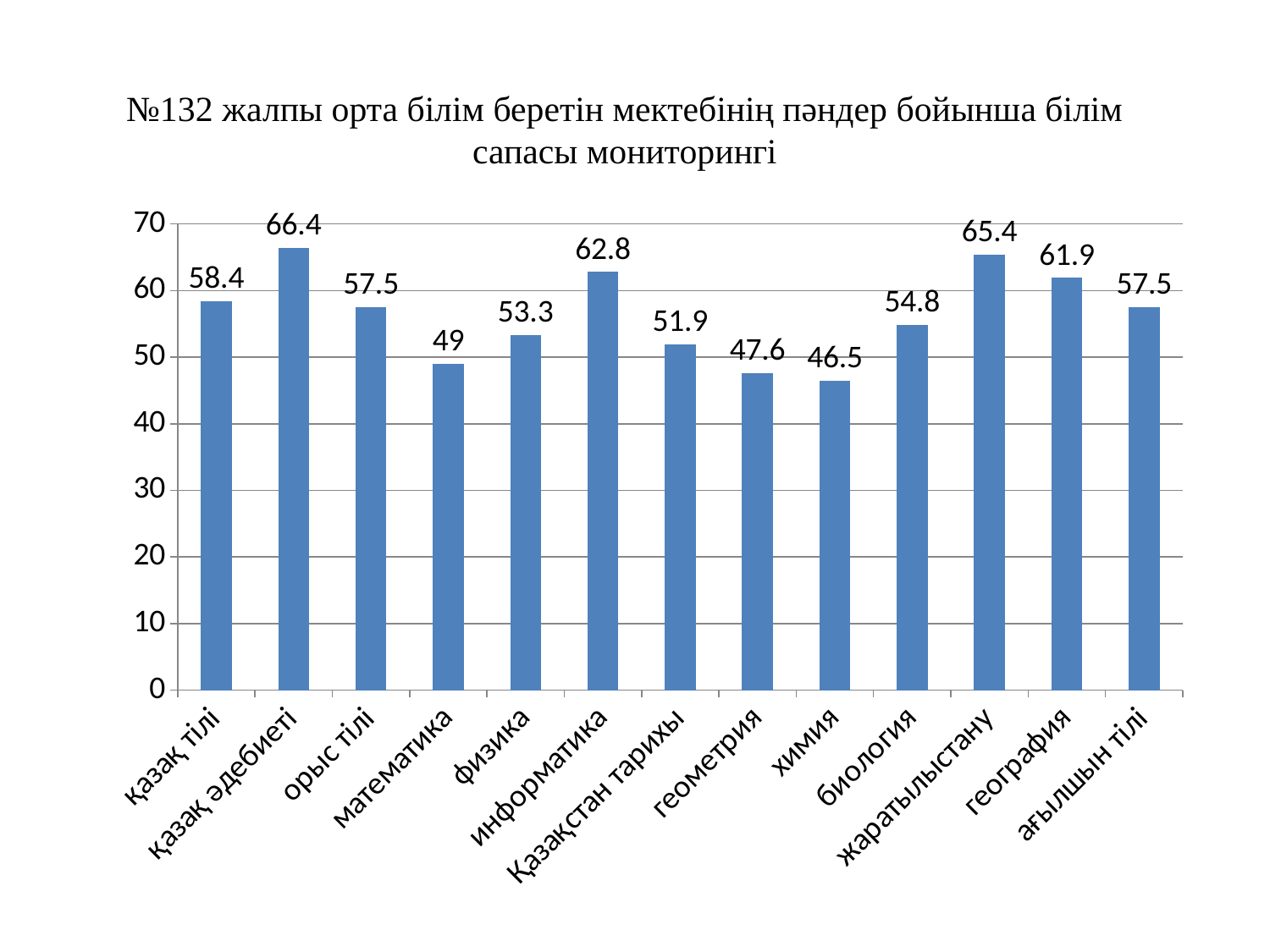
How many subjects are shown on the chart? 13 What kind of chart is shown on the slide? bar chart What is the value for Қазақстан тарихы? 51.9 What is the difference between the values for қазақ әдебиеті and химия? 19.9 Which subject has the lowest value? химия Is the value for геометрия greater or less than 50? less Which is larger, the value for физика or the value for биология? биология Which subject has the highest value? қазақ әдебиеті What is the value for информатика? 62.8 What is the title of the chart? №132 жалпы орта білім беретін мектебінің пәндер бойынша білім сапасы мониторингі What is the value for математика? 49 What is the difference between the values for жаратылыстану and география? 3.5